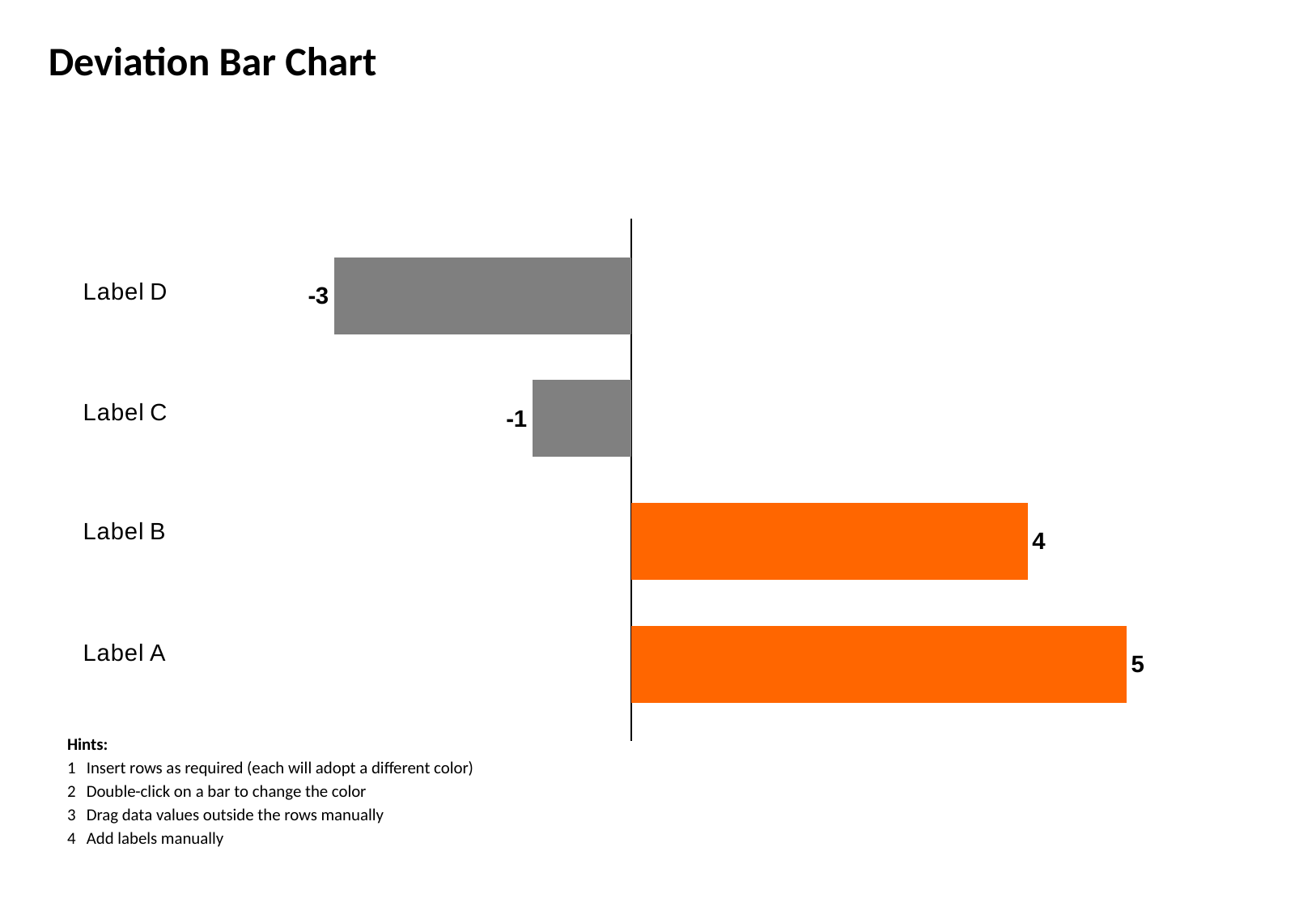
What is the value for Label C? -1 What kind of chart is shown on the slide? Bar chart What is the title of the chart? Deviation Bar Chart What is the difference between the values for Label B and Label D? 7 What is the difference between the values for Label A and Label B? 1 What is the value for Label D? -3 How many categories are shown in the chart? 4 What is the value for Label A? 5 Which category has the highest value? Label A What is the value for Label B? 4 Which category has the lowest value? Label D Which is larger, the value for Label C or the value for Label D? Label C